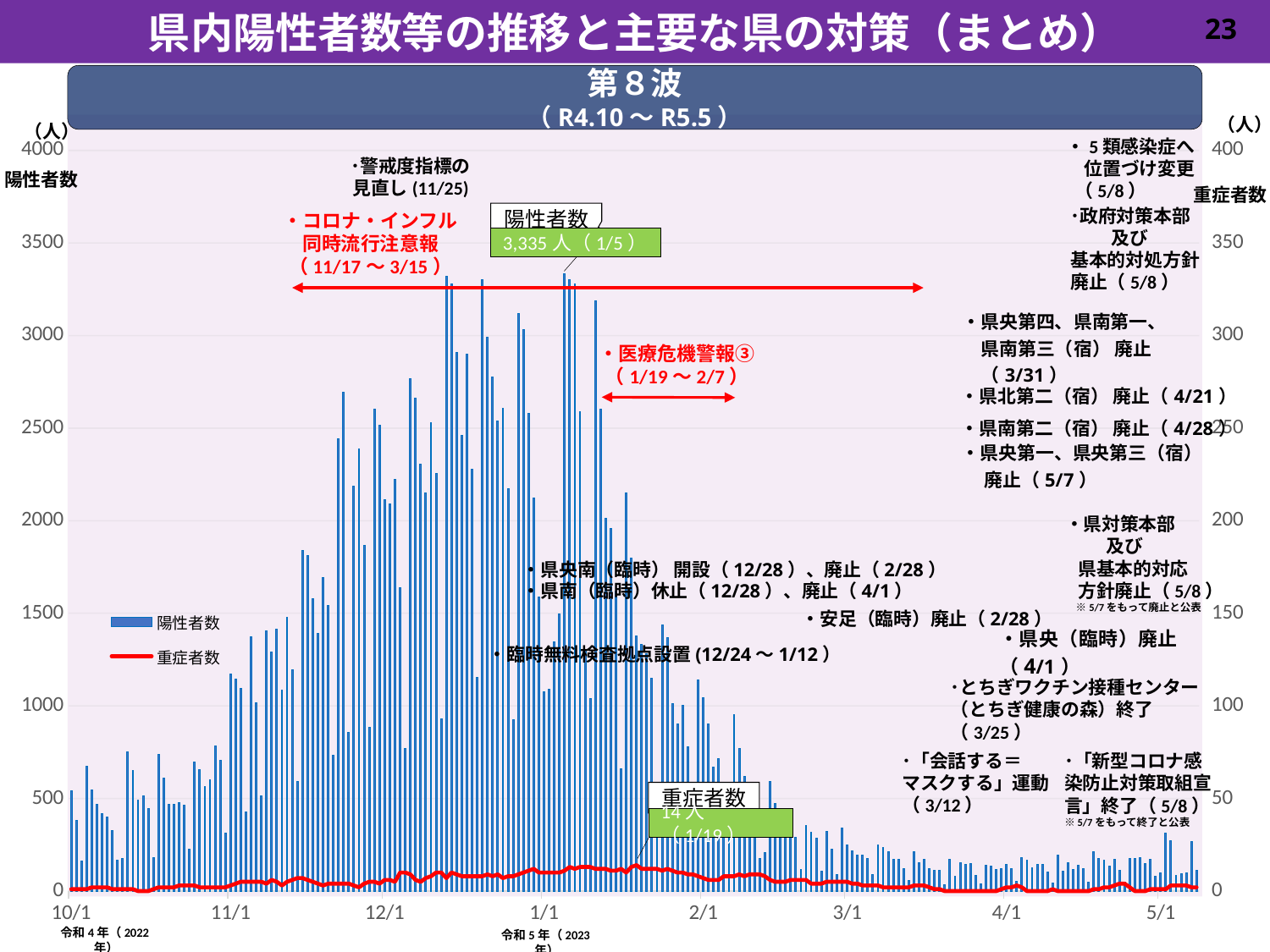
Which is larger: the labelled peak of 陽性者数 (3,335 人) or the labelled peak of 重症者数 (14 人)? 陽性者数 What kind of chart is used to show 陽性者数? Bar chart Which wave does the chart cover, according to the banner above it? 第８波 What is the peak value of 重症者数 shown in the callout on the chart? 14 人 After the peak in early January, do the 陽性者数 values rise or fall toward 5/1? fall On what date did 重症者数 reach its labelled peak of 14 人? 1/19 Are the 陽性者数 values around 5/1 greater or less than 500? less What is the peak value of 陽性者数 shown in the callout on the chart? 3,335 人 How many series does the chart legend list? 2 Is the peak value of 陽性者数 greater or less than 3000? greater What are the two series named in the chart legend? 陽性者数 and 重症者数 On what date did 陽性者数 reach its labelled peak of 3,335 人? 1/5